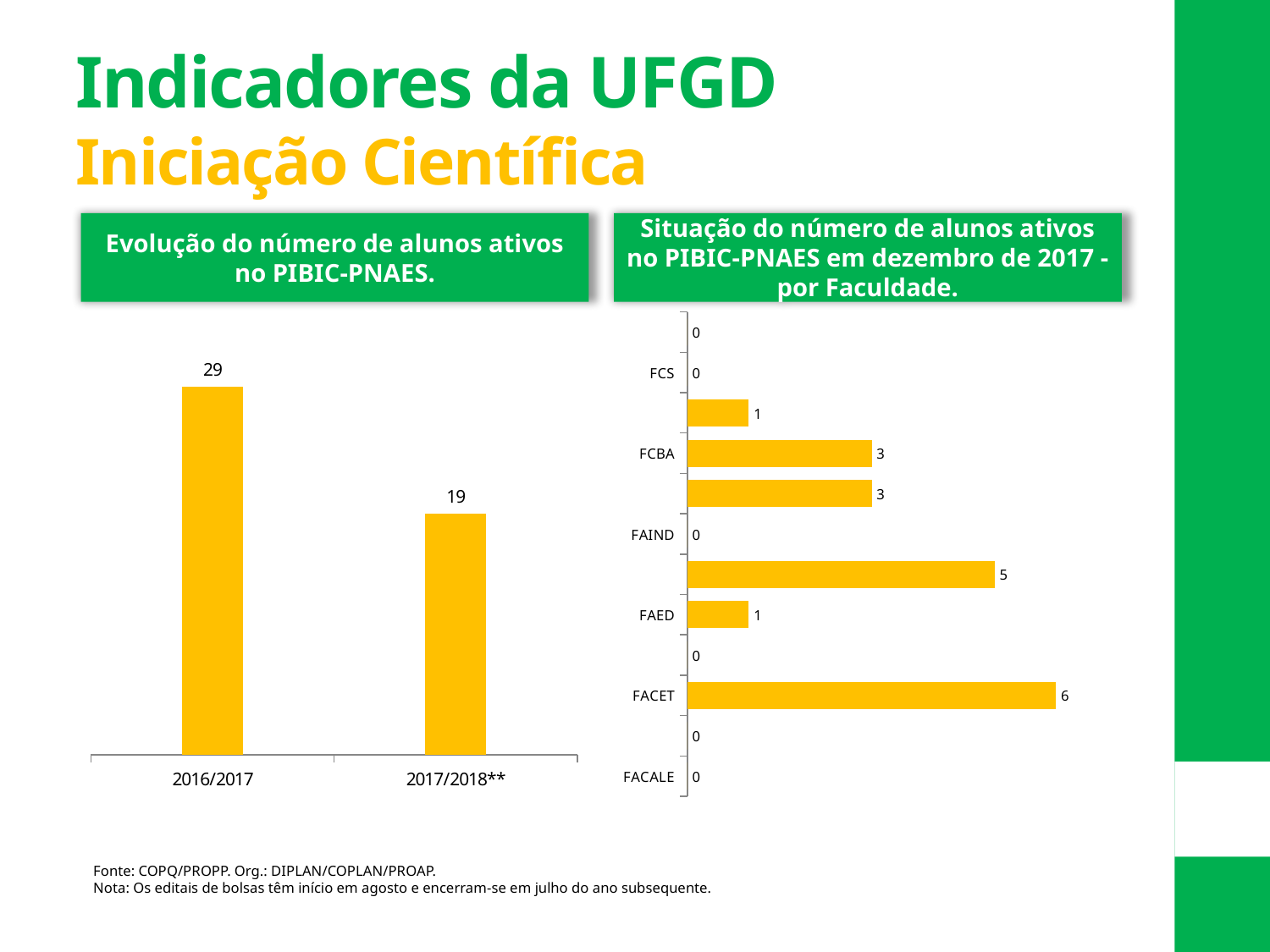
In the chart 'Situação do número de alunos ativos no PIBIC-PNAES em dezembro de 2017 - por Faculdade', what is the value for FAED? 1 In the chart 'Evolução do número de alunos ativos no PIBIC-PNAES', what is the value for 2017/2018**? 19 In the chart 'Evolução do número de alunos ativos no PIBIC-PNAES', what is the difference between the 2016/2017 and 2017/2018** values? 10 In the chart 'Situação do número de alunos ativos no PIBIC-PNAES em dezembro de 2017 - por Faculdade', which is larger, the value for FCBA or the value for FAED? FCBA What kind of chart is 'Situação do número de alunos ativos no PIBIC-PNAES em dezembro de 2017 - por Faculdade'? bar chart In the chart 'Situação do número de alunos ativos no PIBIC-PNAES em dezembro de 2017 - por Faculdade', what is the value for FCBA? 3 In the chart 'Situação do número de alunos ativos no PIBIC-PNAES em dezembro de 2017 - por Faculdade', which labelled faculty has the highest value? FACET In the chart 'Evolução do número de alunos ativos no PIBIC-PNAES', how many categories are shown on the x axis? 2 What kind of chart is 'Evolução do número de alunos ativos no PIBIC-PNAES'? bar chart In the chart 'Situação do número de alunos ativos no PIBIC-PNAES em dezembro de 2017 - por Faculdade', what is the value for FACET? 6 In the chart 'Evolução do número de alunos ativos no PIBIC-PNAES', what is the value for 2016/2017? 29 In the chart 'Evolução do número de alunos ativos no PIBIC-PNAES', do the values rise or fall from 2016/2017 to 2017/2018**? fall